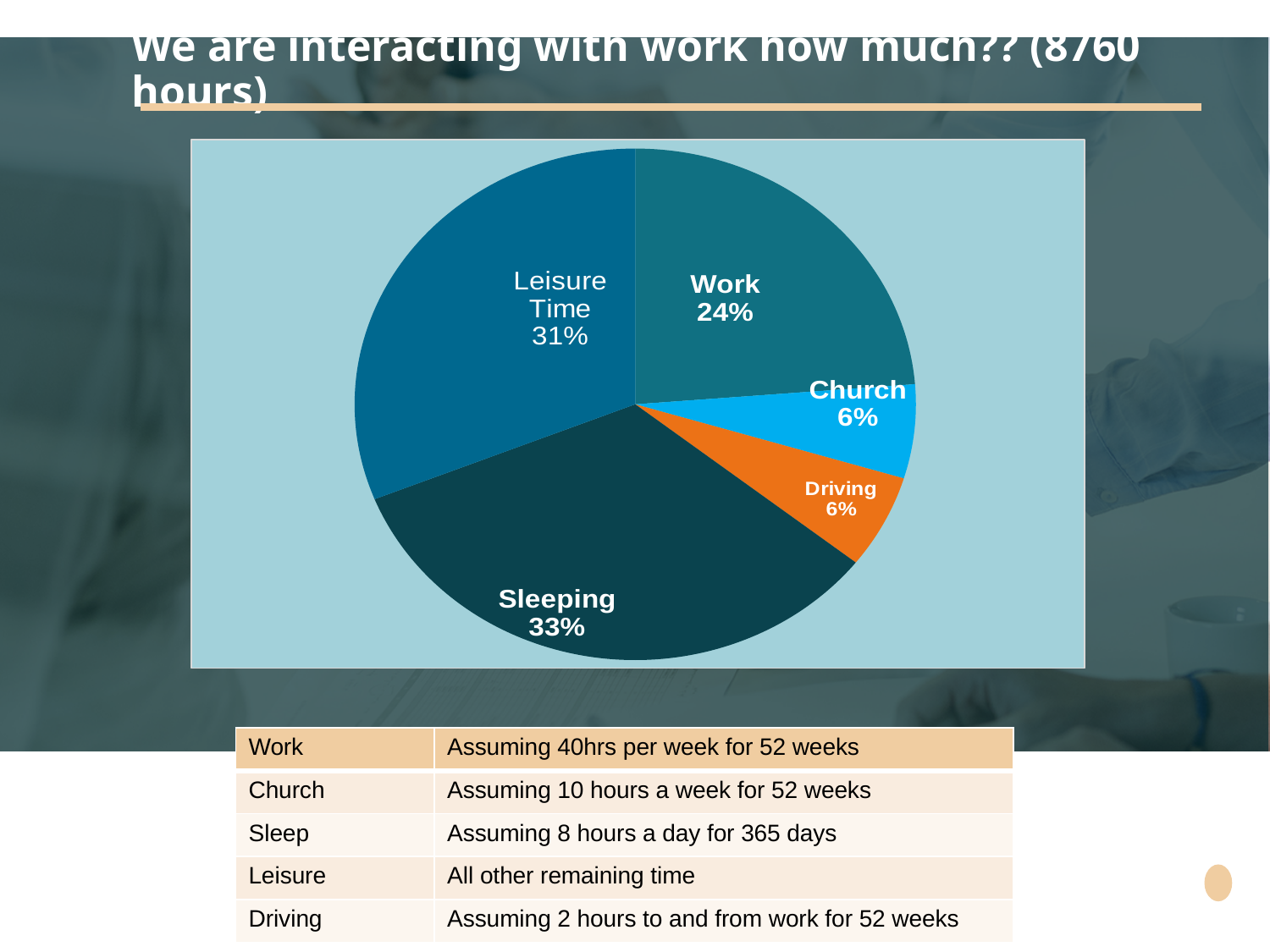
What share of the pie does Leisure Time take? 31% How many slices does the pie chart have? 5 Which is larger, the Leisure Time slice or the Work slice? Leisure Time What colour is the Driving slice? orange What share of the pie does Church take? 6% What share of the pie does Work take? 24% Which slice of the pie is the largest? Sleeping What kind of chart is shown on the slide? pie chart What is the combined share of the Church and Driving slices? 12% What is the difference in percentage points between the Sleeping slice and the Work slice? 9% What is the difference in percentage points between the Leisure Time slice and the Church slice? 25%